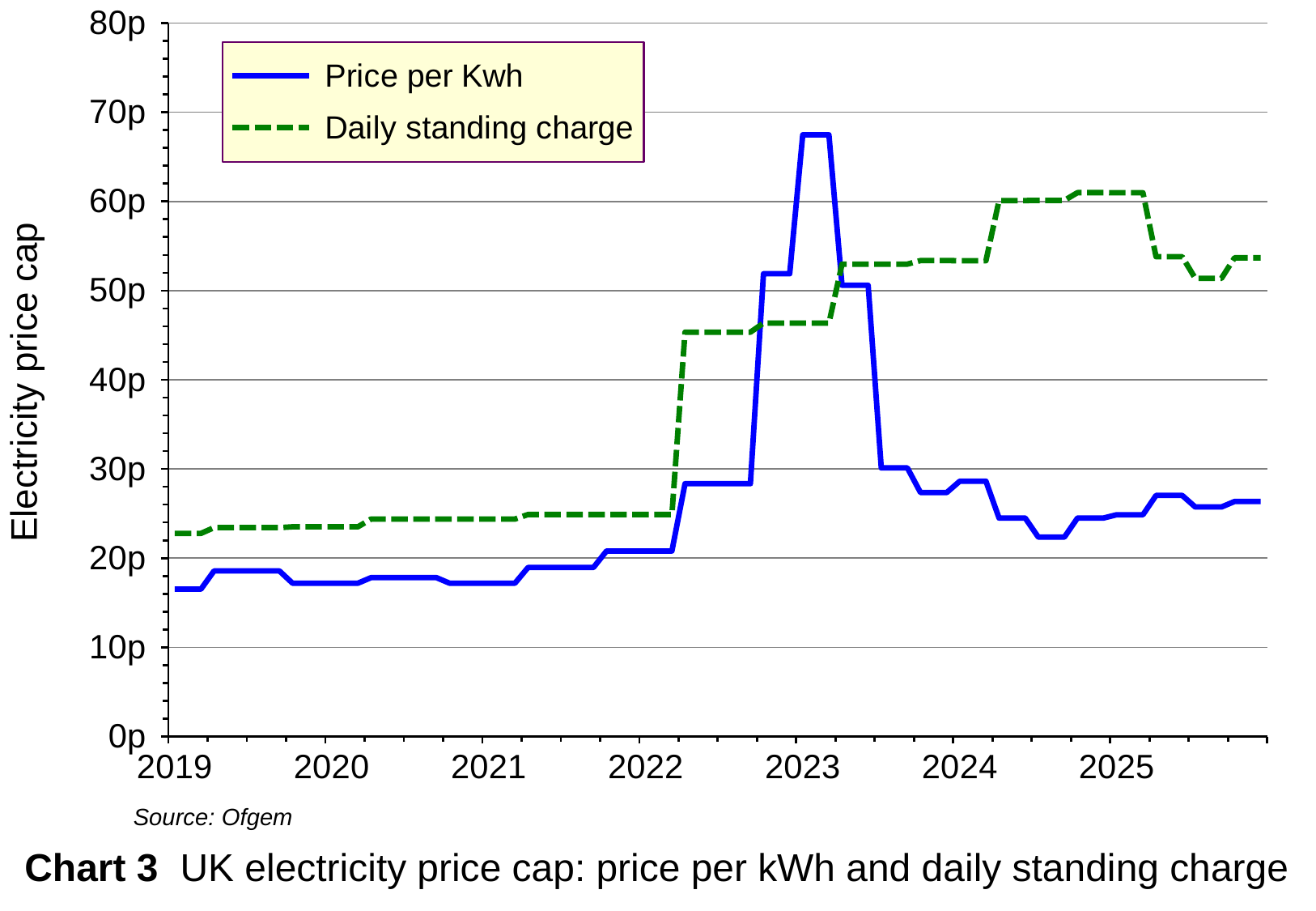
How many series does the legend list? 2 In which year does Price per Kwh reach its highest value? 2023 During 2025, which series is higher, Price per Kwh or Daily standing charge? Daily standing charge Is the value for Price per Kwh at the start of 2019 greater or less than 20p? less What is the title of the chart? Chart 3 UK electricity price cap: price per kWh and daily standing charge Overall, does the Daily standing charge rise or fall between 2019 and 2025? rise Is the value for Daily standing charge at the start of 2019 greater or less than 20p? greater Is the value for Price per Kwh at the end of 2025 greater or less than 30p? less What are the two series named in the legend? Price per Kwh; Daily standing charge What kind of chart is shown on the slide? line chart